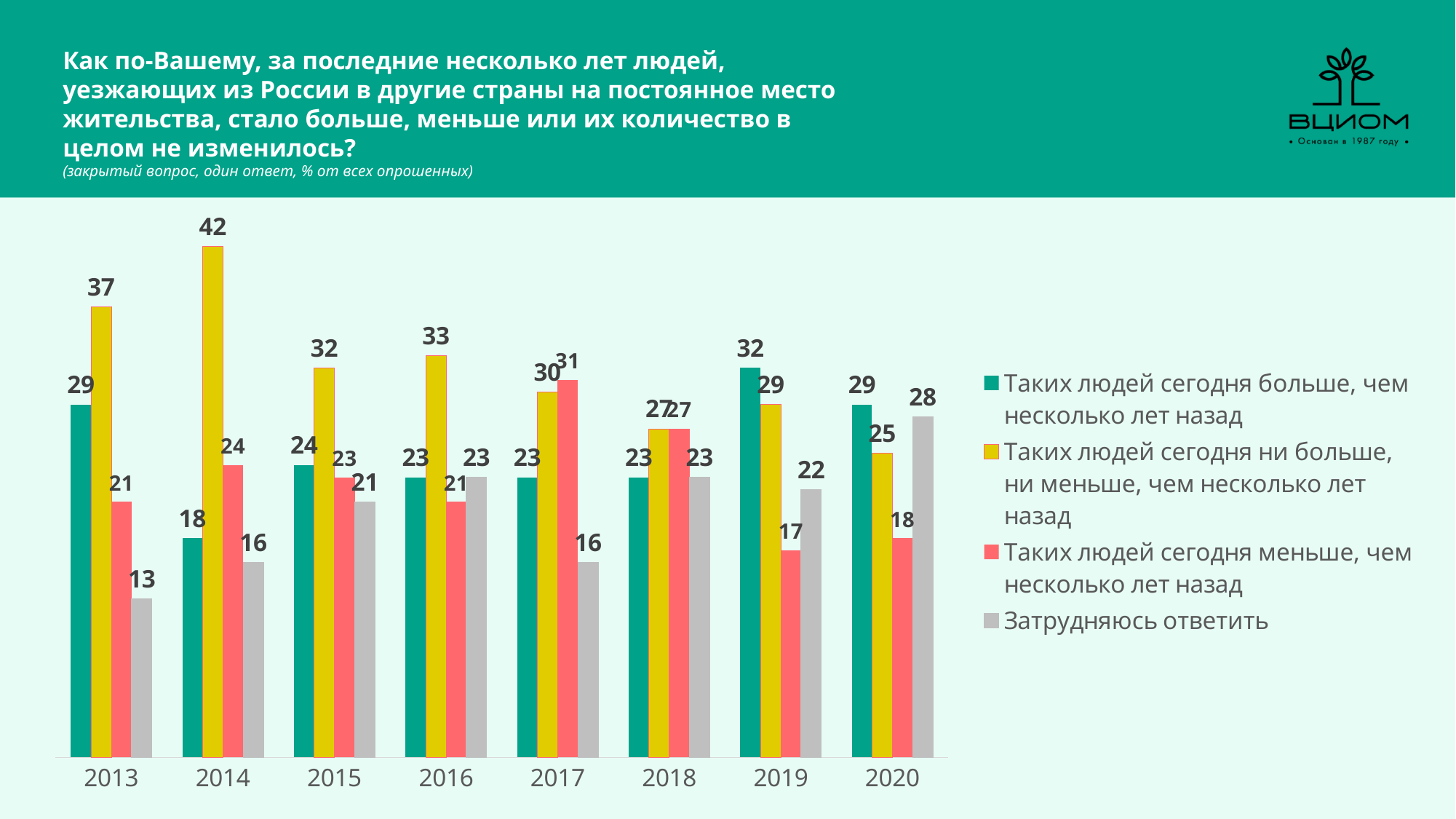
In which year is the value of the series "Затрудняюсь ответить" lowest? 2013 In which year is the value of the series "Таких людей сегодня ни больше, ни меньше, чем несколько лет назад" highest? 2014 What is the value for 2014 in the series "Таких людей сегодня ни больше, ни меньше, чем несколько лет назад"? 42 What is the value for 2017 in the series "Таких людей сегодня меньше, чем несколько лет назад"? 31 In 2020, which is larger: the value for "Таких людей сегодня больше, чем несколько лет назад" or for "Таких людей сегодня ни больше, ни меньше, чем несколько лет назад"? Таких людей сегодня больше, чем несколько лет назад What is the value for 2020 in the series "Затрудняюсь ответить"? 28 What is the value for 2019 in the series "Таких людей сегодня больше, чем несколько лет назад"? 32 How many years are shown on the x axis of the chart? 8 What kind of chart is shown on the slide? Bar chart Which colour represents the series "Затрудняюсь ответить" in the chart? Grey How many series does the legend list? 4 What is the difference between the 2014 and 2013 values of the series "Таких людей сегодня больше, чем несколько лет назад"? 11